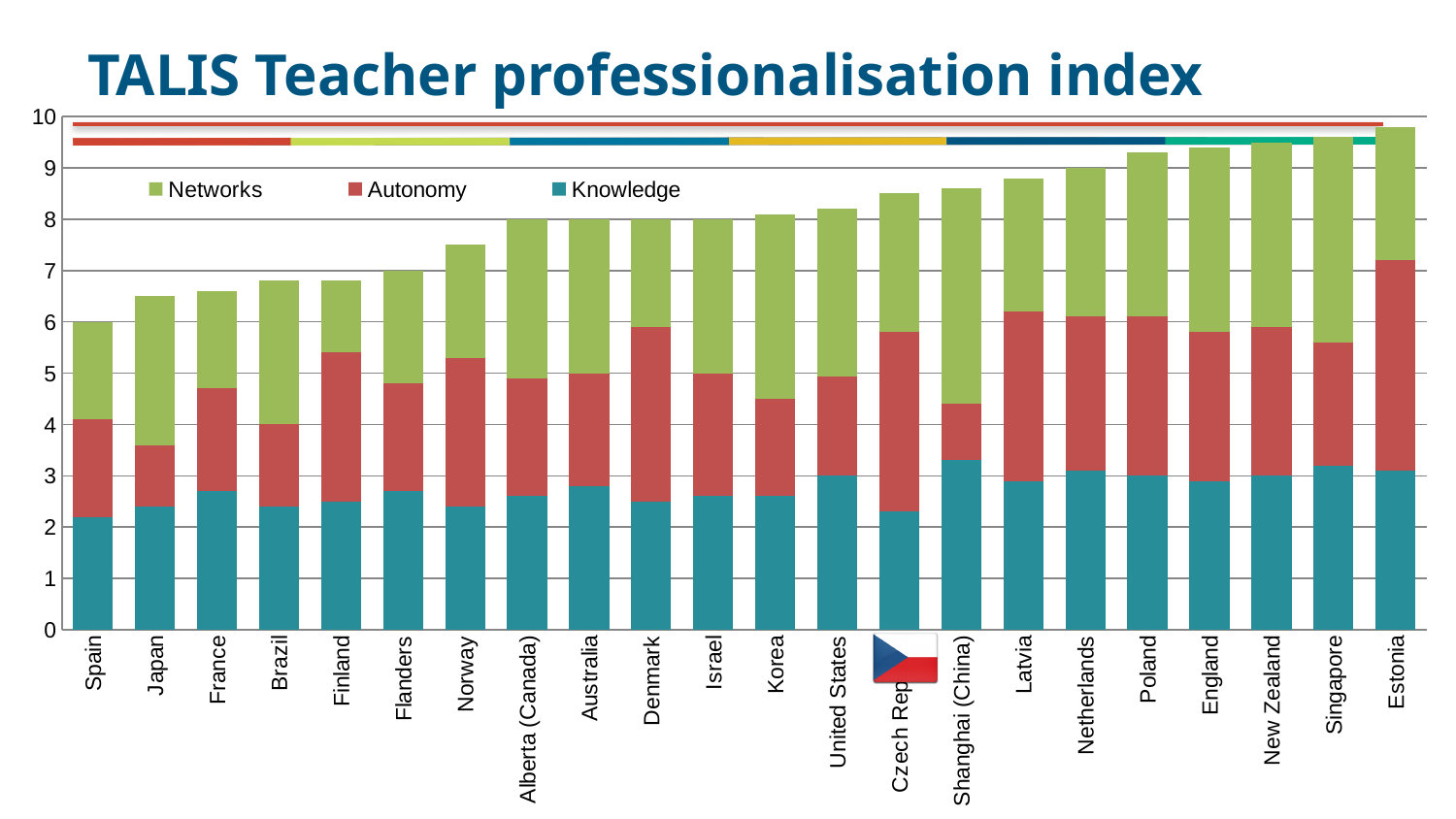
What kind of chart is shown on the slide? Stacked bar chart Is the total index for Latvia greater or less than 8? greater Is the total index for Japan greater or less than 7? less Do the total bar heights rise or fall from left to right along the x axis? Rise How many series does the legend list? 3 Which country has the highest total professionalisation index? Estonia Which has a larger total index, Singapore or Japan? Singapore Which series is shown in green in the legend? Networks Which country has the lowest total professionalisation index? Spain Is the Knowledge value for Shanghai (China) greater or less than 3? greater How many countries or regions are shown along the x axis? 22